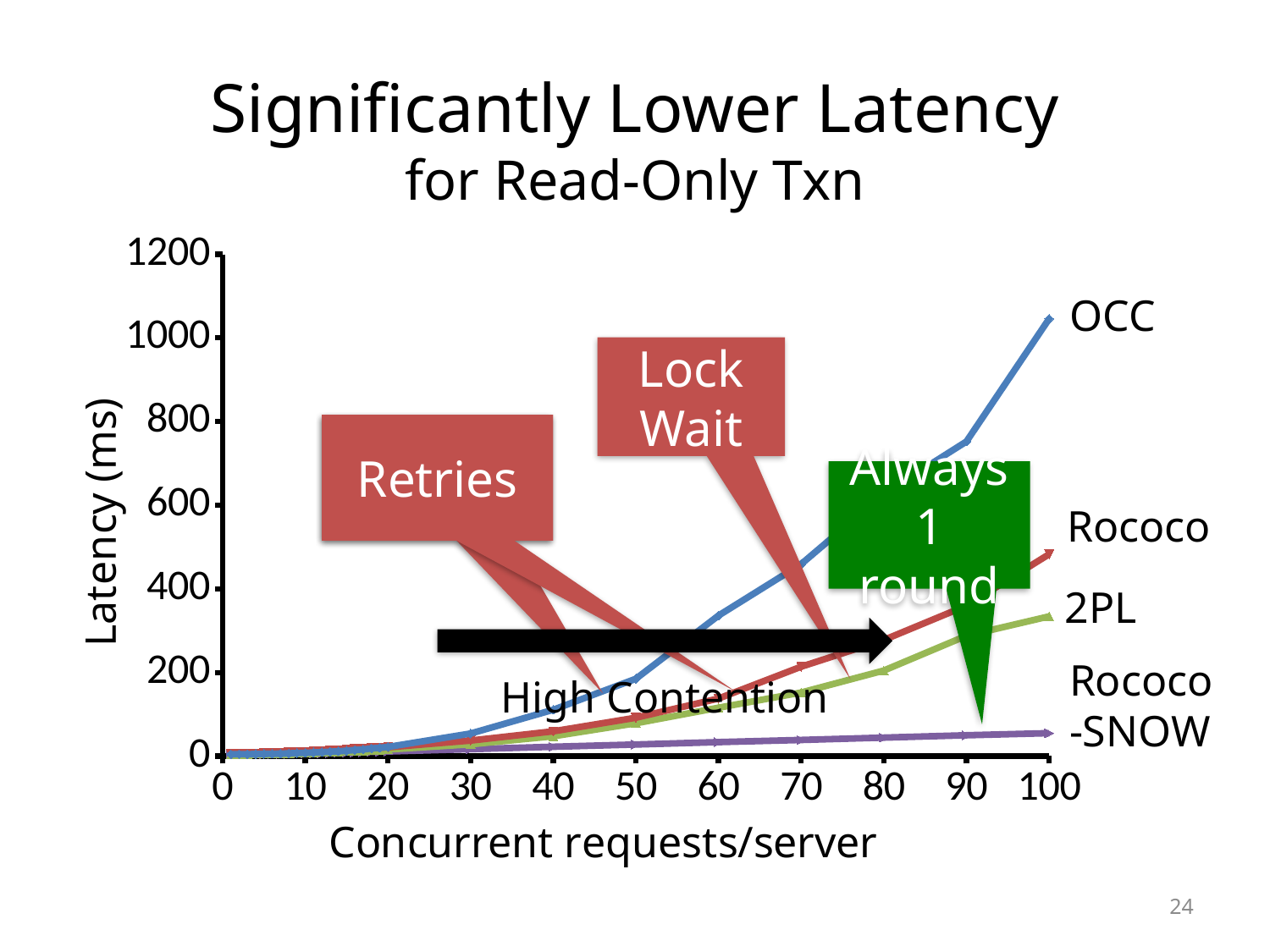
Is the latency for Rococo at 100 concurrent requests/server greater or less than 400 ms? greater Which series has the highest latency at 100 concurrent requests/server? OCC Which series has the lowest latency at 100 concurrent requests/server? Rococo-SNOW What kind of chart is shown on the slide? line chart Is the latency for OCC at 100 concurrent requests/server greater or less than 1000 ms? greater Is the latency for Rococo-SNOW at 100 concurrent requests/server greater or less than 200 ms? less What is the label of the x axis? Concurrent requests/server At 100 concurrent requests/server, which has higher latency: OCC or Rococo? OCC What is the label of the y axis? Latency (ms) How many series (lines) are plotted on the chart? 4 Does the latency for OCC rise or fall as concurrent requests/server increase? rise